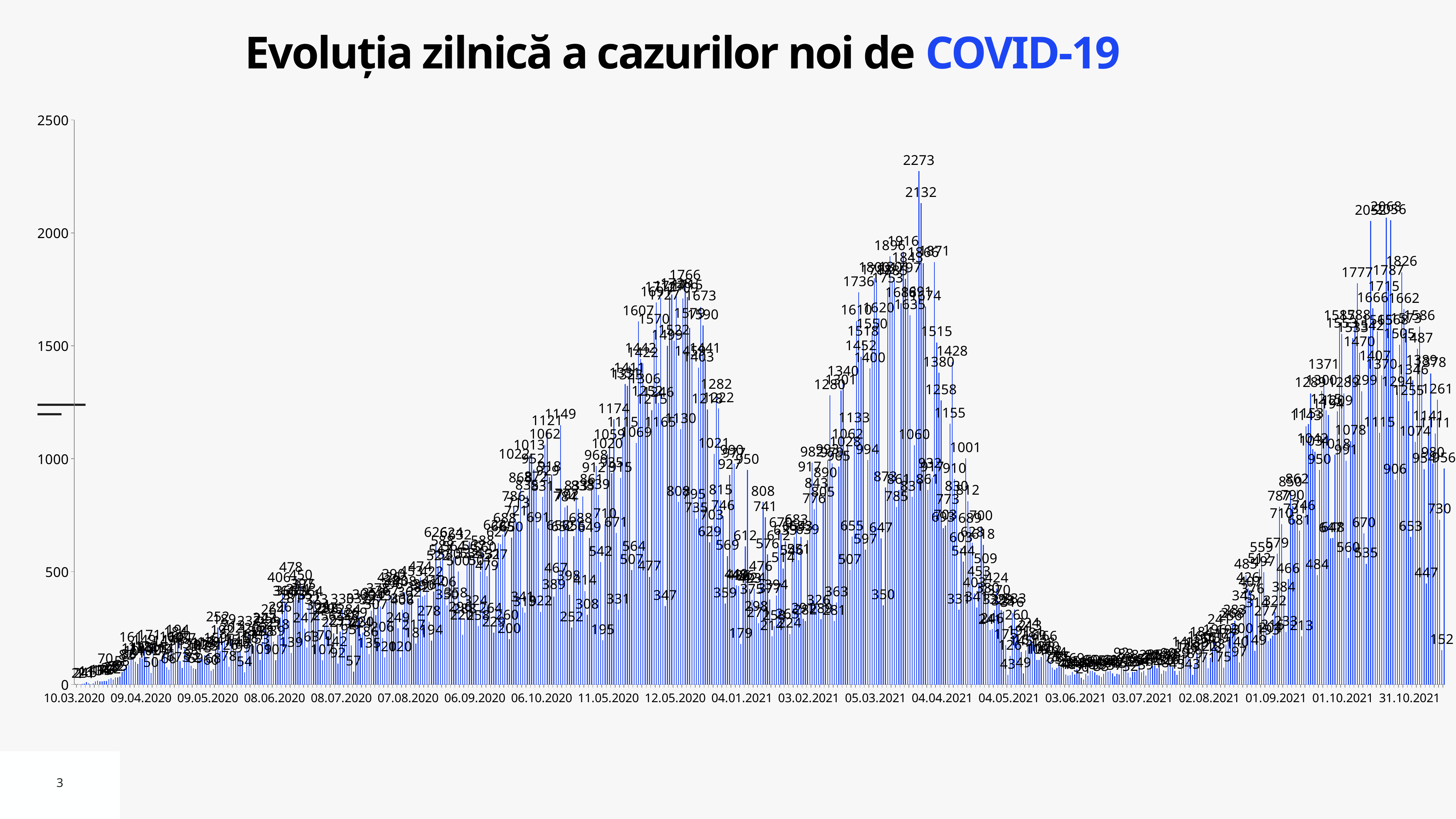
What is the highest daily value labelled on the chart? 2273 Are the bars around the x-axis label 12.05.2020 greater or less than 1000? greater Is the tallest bar on the chart located in 2020 or in 2021? 2021 Is the tallest bar on the chart greater or less than 2000? greater Between the x-axis labels 04.04.2021 and 03.06.2021, do the values generally rise or fall? fall What is the first date label shown on the x axis? 10.03.2020 What is the value labelled on the last bar at the far right of the chart? 956 Are the bars around the x-axis label 03.06.2021 greater or less than 500? less What is the second-highest value labelled on the chart, just next to the 2273 peak? 2132 What kind of chart is shown on the slide? bar chart What is the title of the chart on the slide? Evoluția zilnică a cazurilor noi de COVID-19 Between the x-axis labels 03.07.2021 and 31.10.2021, do the values generally rise or fall? rise